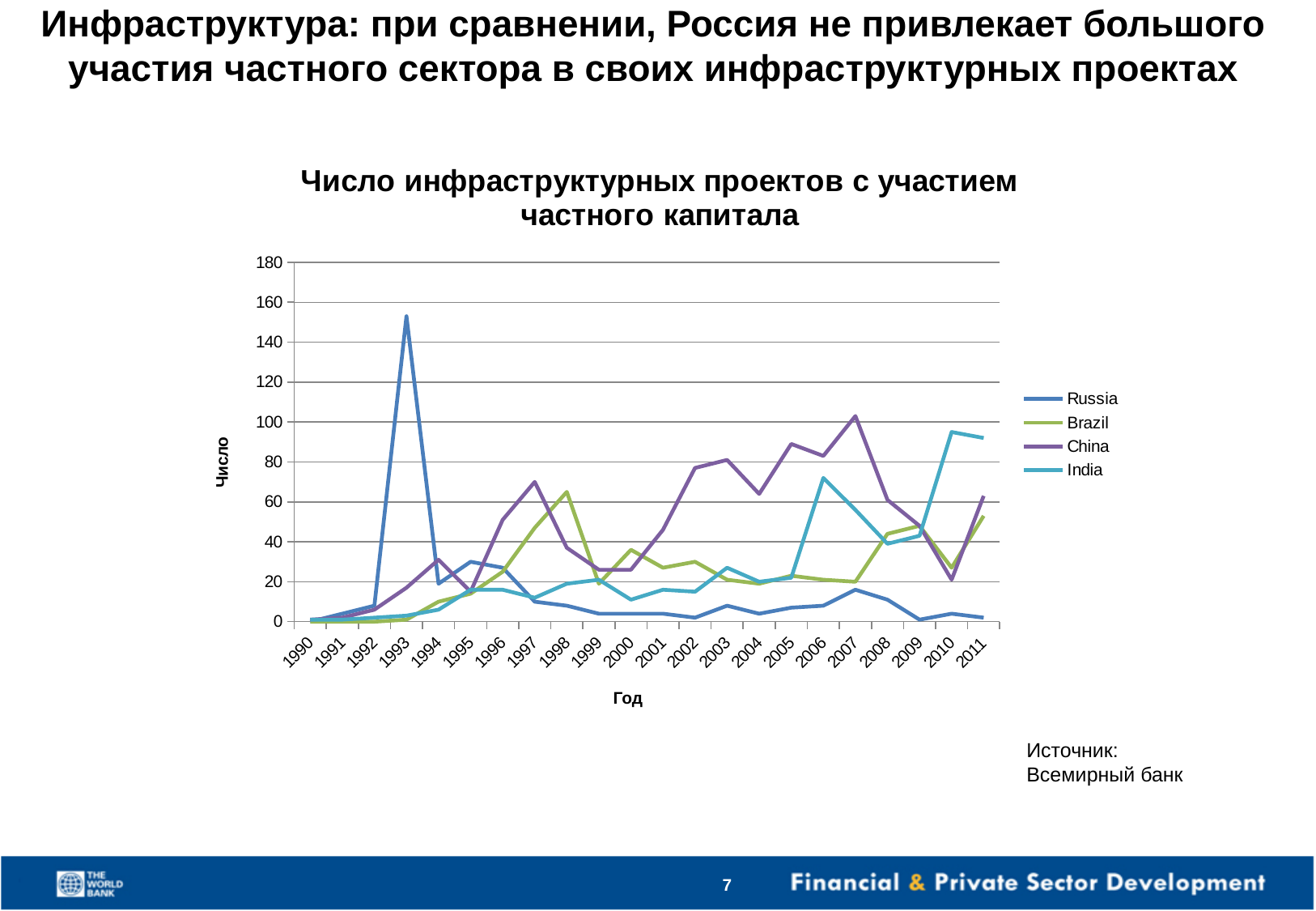
In 1998, which is larger: the value for Brazil or the value for China? Brazil Is the value for Brazil in 2011 greater or less than 40? greater Is the value for India in 2010 greater or less than 80? greater How many series does the legend list? 4 Which series are listed in the legend? Russia, Brazil, China, India What kind of chart is shown on the slide? line chart Does the Russia line rise or fall from 1993 to 1994? fall How many years are shown along the x axis? 22 Is the value for China in 2007 greater or less than 80? greater In which year does the Russia line reach its highest value? 1993 Which series has the lowest value in 2011? Russia